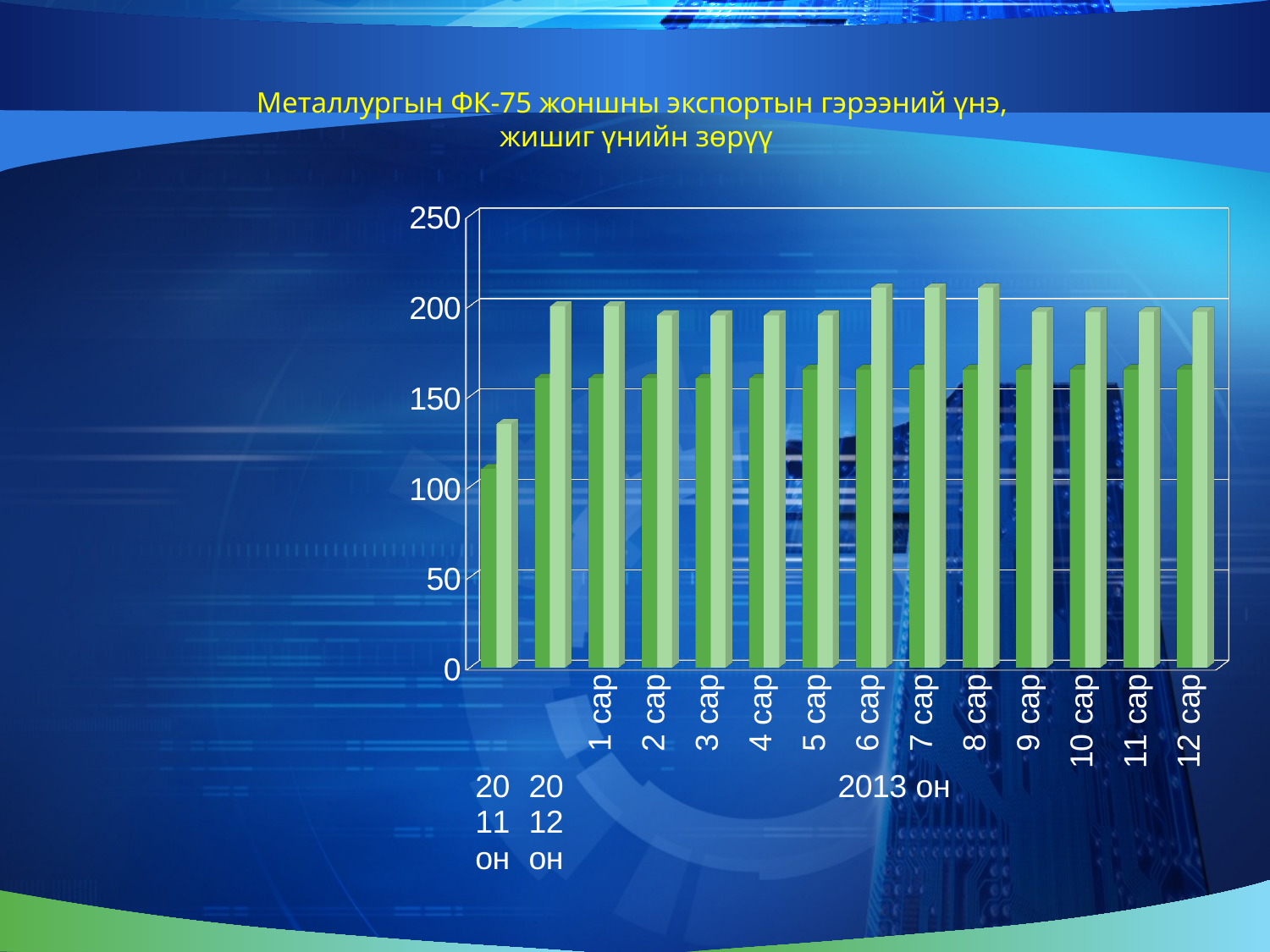
How many bars are plotted for each category? 2 Do the bars rise or fall from 2011 он to 2012 он? rise How many months of 2013 (сар) are shown on the x axis? 12 What is the title of the chart on the slide? Металлургын ФК-75 жоншны экспортын гэрээний үнэ, жишиг үнийн зөрүү Is the light green bar for 6 сар greater or less than 200? greater Is the dark green bar for 2011 он greater or less than 150? less Which category has the lowest bars? 2011 он What kind of chart is shown on the slide? Bar chart Which has the larger light green bar, 2011 он or 2012 он? 2012 он Is the light green bar for 2011 он greater or less than 150? less How many category groups are plotted along the x axis? 14